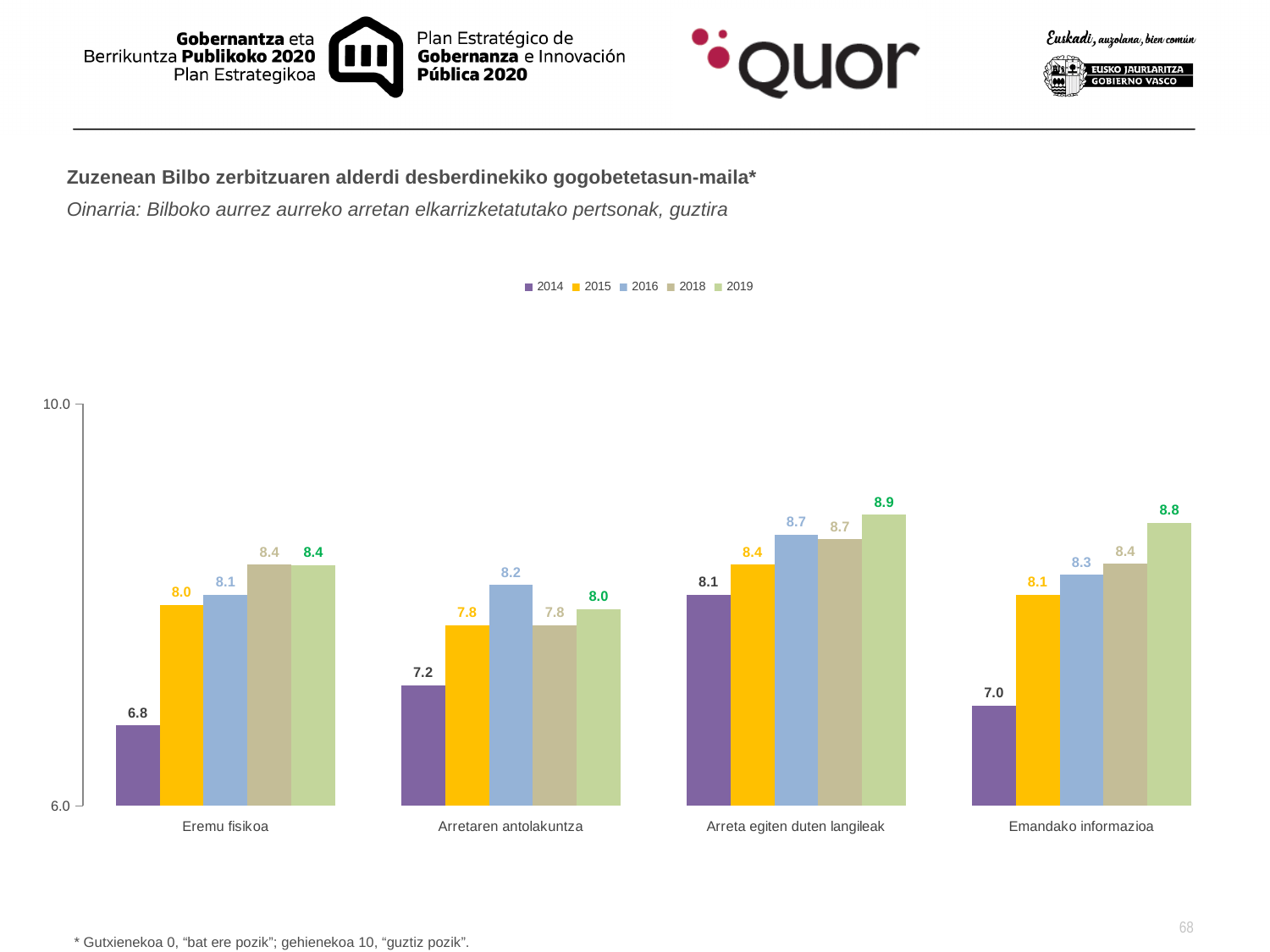
Which category has the highest 2019 value? Arreta egiten duten langileak What is the difference between the 2019 and 2014 values in the "Emandako informazioa" category? 1.8 What is the value for 2016 in the "Arretaren antolakuntza" category? 8.2 What kind of chart is shown on the slide? Bar chart Which category has the lowest 2014 value? Eremu fisikoa Which is larger in the "Arretaren antolakuntza" category: the 2016 value or the 2019 value? 2016 How many series does the legend list? 5 How many categories are shown on the x axis? 4 What is the value for 2014 in the "Eremu fisikoa" category? 6.8 What is the value for 2018 in the "Emandako informazioa" category? 8.4 What is the value for 2019 in the "Arreta egiten duten langileak" category? 8.9 Do the values in the "Arreta egiten duten langileak" category rise or fall from 2014 to 2019? Rise